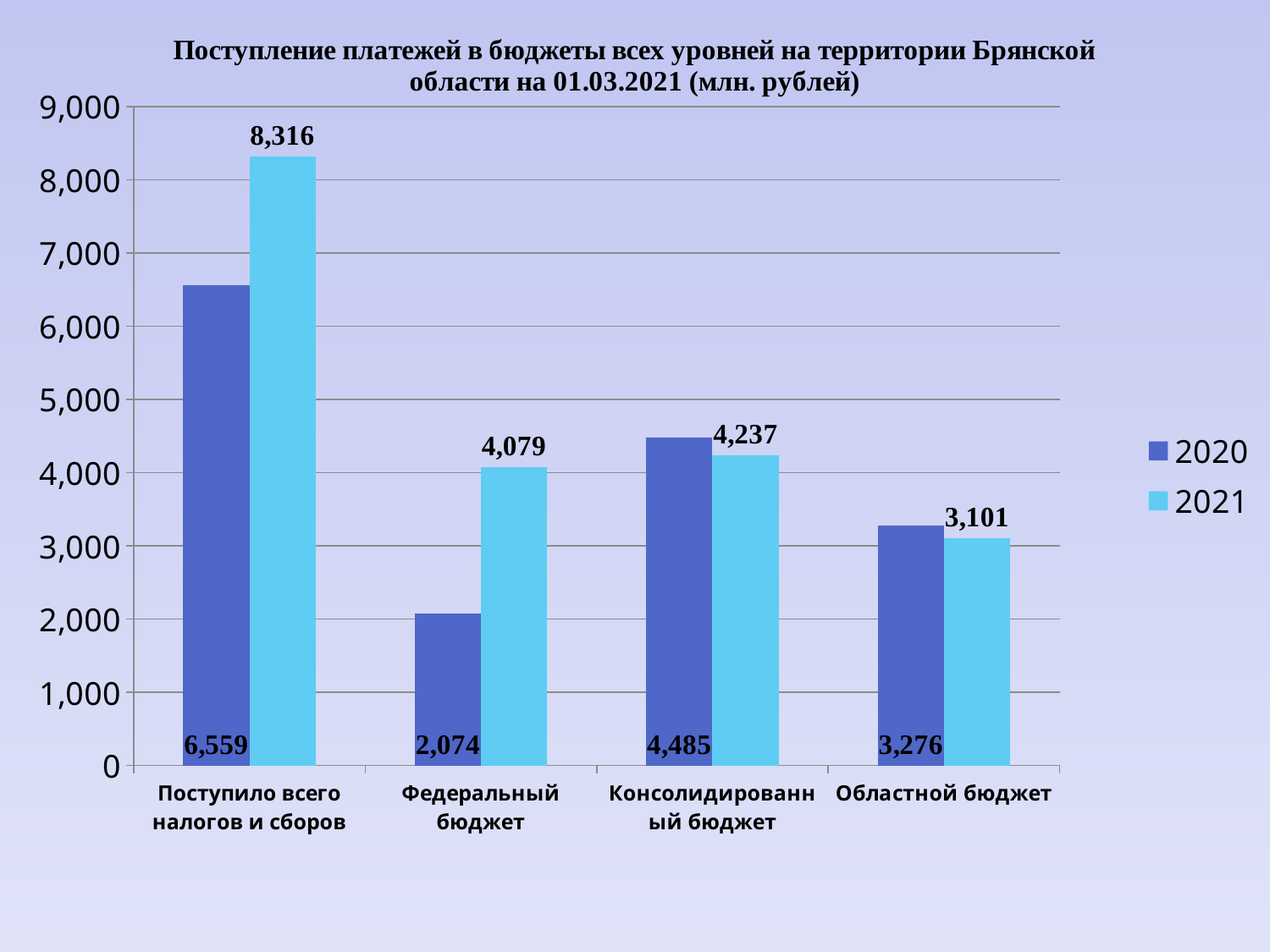
For Областной бюджет, which is larger: the 2020 value or the 2021 value? 2020 What is the 2020 value for Консолидированный бюджет? 4,485 What is the 2021 value for Поступило всего налогов и сборов? 8,316 How many categories are shown on the x axis? 4 What is the 2020 value for Федеральный бюджет? 2,074 Which category has the lowest 2020 value? Федеральный бюджет What is the difference between the 2021 and 2020 values for Федеральный бюджет? 2,005 How many series does the legend list? 2 What is the 2021 value for Областной бюджет? 3,101 Which category has the highest 2021 value? Поступило всего налогов и сборов Which series is shown in light blue in the legend? 2021 What kind of chart is shown on the slide? bar chart